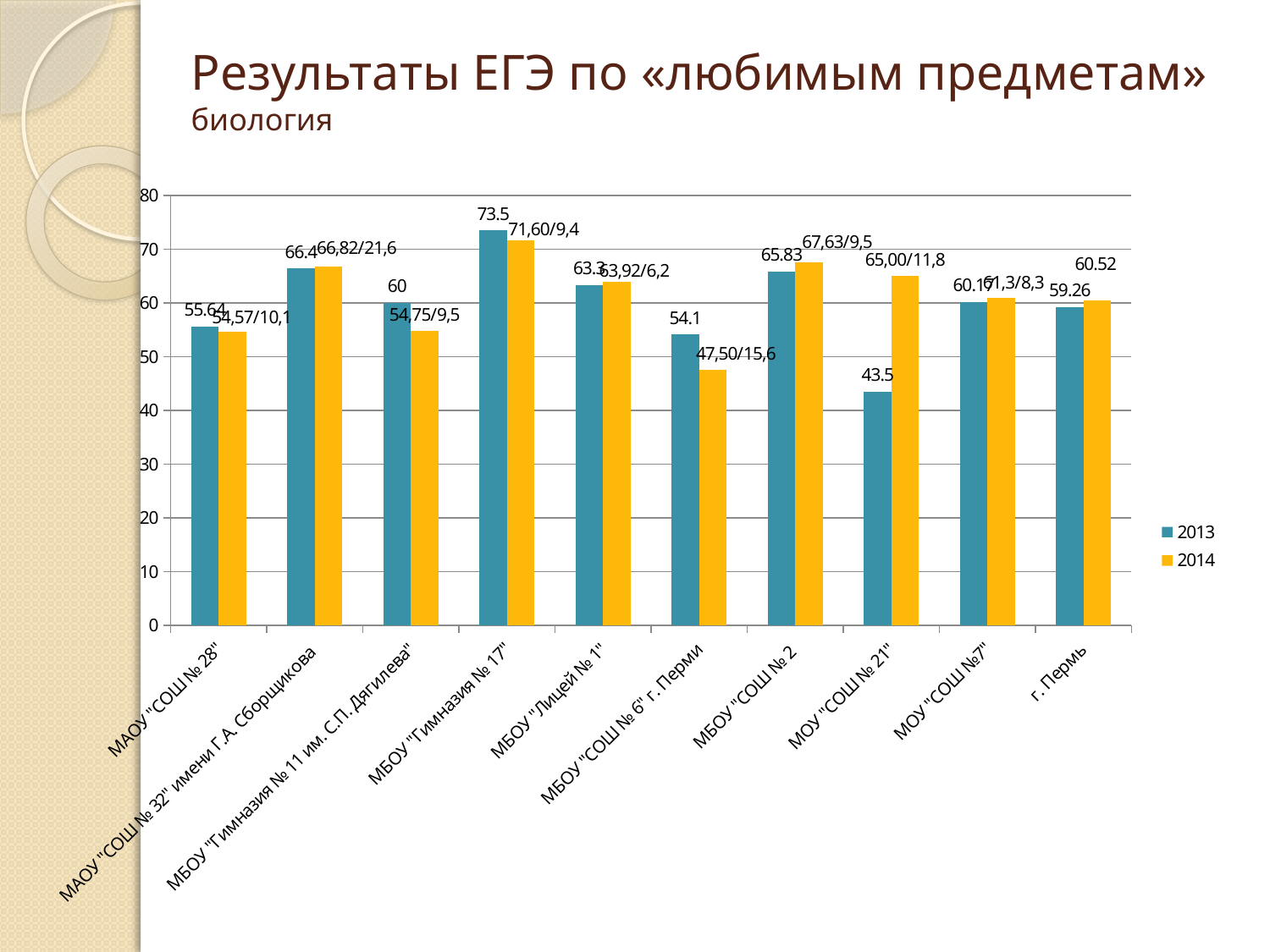
What is the 2014 data label for МБОУ "СОШ № 6" г. Перми? 47,50/15,6 How many categories are shown on the x axis? 10 What is the 2013 value for МОУ "СОШ № 21"? 43.5 What is the 2013 value for МБОУ "Гимназия № 17"? 73.5 For МОУ "СОШ № 21", which is larger: the 2013 value or the 2014 value? 2014 What is the difference between the 2013 values for МБОУ "Гимназия № 17" and МОУ "СОШ № 21"? 30 How many series does the legend list? 2 Which category has the highest 2013 value? МБОУ "Гимназия № 17" What is the 2014 value for г. Пермь? 60.52 Which category has the lowest 2013 value? МОУ "СОШ № 21" What is the 2013 value for МБОУ "СОШ № 2"? 65.83 What kind of chart is shown on the slide? bar chart